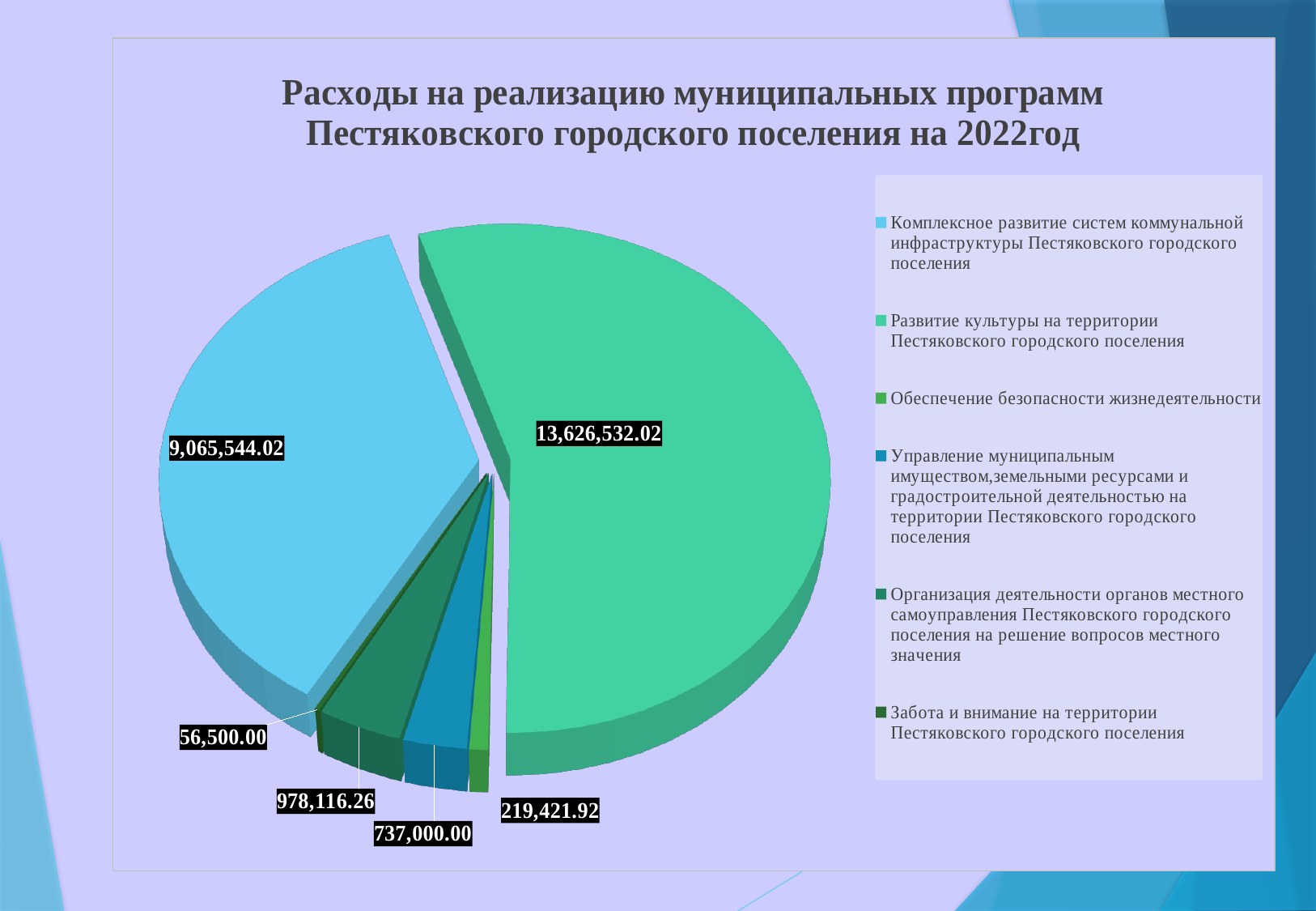
What is the value for «Обеспечение безопасности жизнедеятельности»? 219,421.92 What is the value for «Комплексное развитие систем коммунальной инфраструктуры Пестяковского городского поселения»? 9,065,544.02 What kind of chart is shown on the slide? Pie chart How many slices does the pie chart have? 6 Which program has the smallest slice of the pie? Забота и внимание на территории Пестяковского городского поселения How many entries does the legend list? 6 What is the value for «Развитие культуры на территории Пестяковского городского поселения»? 13,626,532.02 What is the title of the chart? Расходы на реализацию муниципальных программ Пестяковского городского поселения на 2022год What is the difference between the value for «Развитие культуры» and the value for «Комплексное развитие систем коммунальной инфраструктуры»? 4,560,988.00 Which is larger: the value for «Организация деятельности органов местного самоуправления» (978,116.26) or the value for «Управление муниципальным имуществом» (737,000.00)? Организация деятельности органов местного самоуправления What is the value for «Забота и внимание на территории Пестяковского городского поселения»? 56,500.00 Which program has the largest share of the pie? Развитие культуры на территории Пестяковского городского поселения